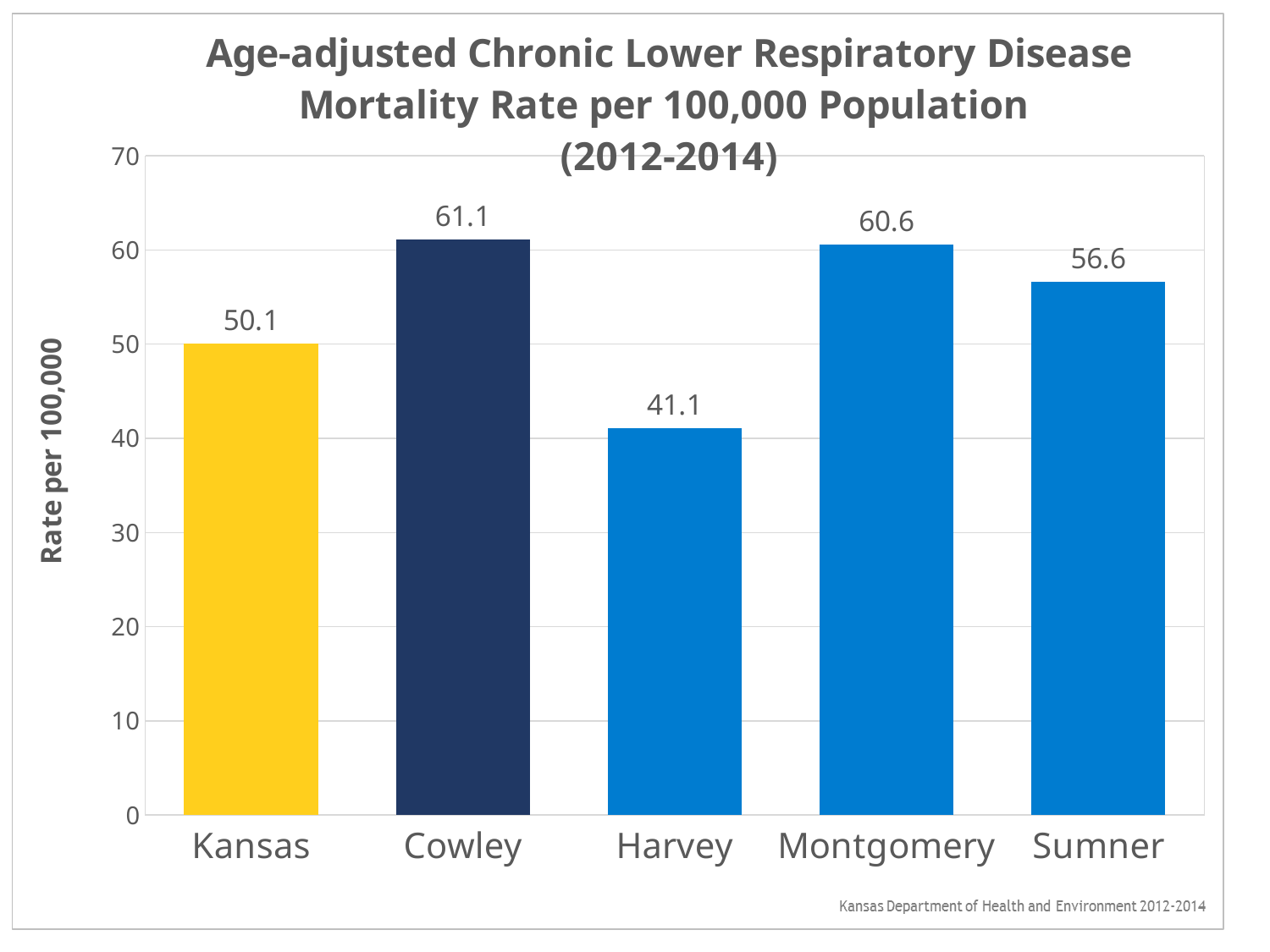
Which has a higher mortality rate, Sumner or Kansas? Sumner What is the mortality rate per 100,000 shown for Kansas? 50.1 Which category has the highest mortality rate? Cowley Is the value for Montgomery greater or less than 50? greater What is the difference between the mortality rates for Montgomery and Kansas? 10.5 Which category has the lowest mortality rate? Harvey What is the age-adjusted chronic lower respiratory disease mortality rate for Cowley? 61.1 What is the mortality rate shown for Harvey? 41.1 What is the mortality rate shown for Sumner? 56.6 How many categories are shown on the x axis? 5 What kind of chart is shown on the slide? Bar chart What is the difference between the mortality rates for Cowley and Harvey? 20.0